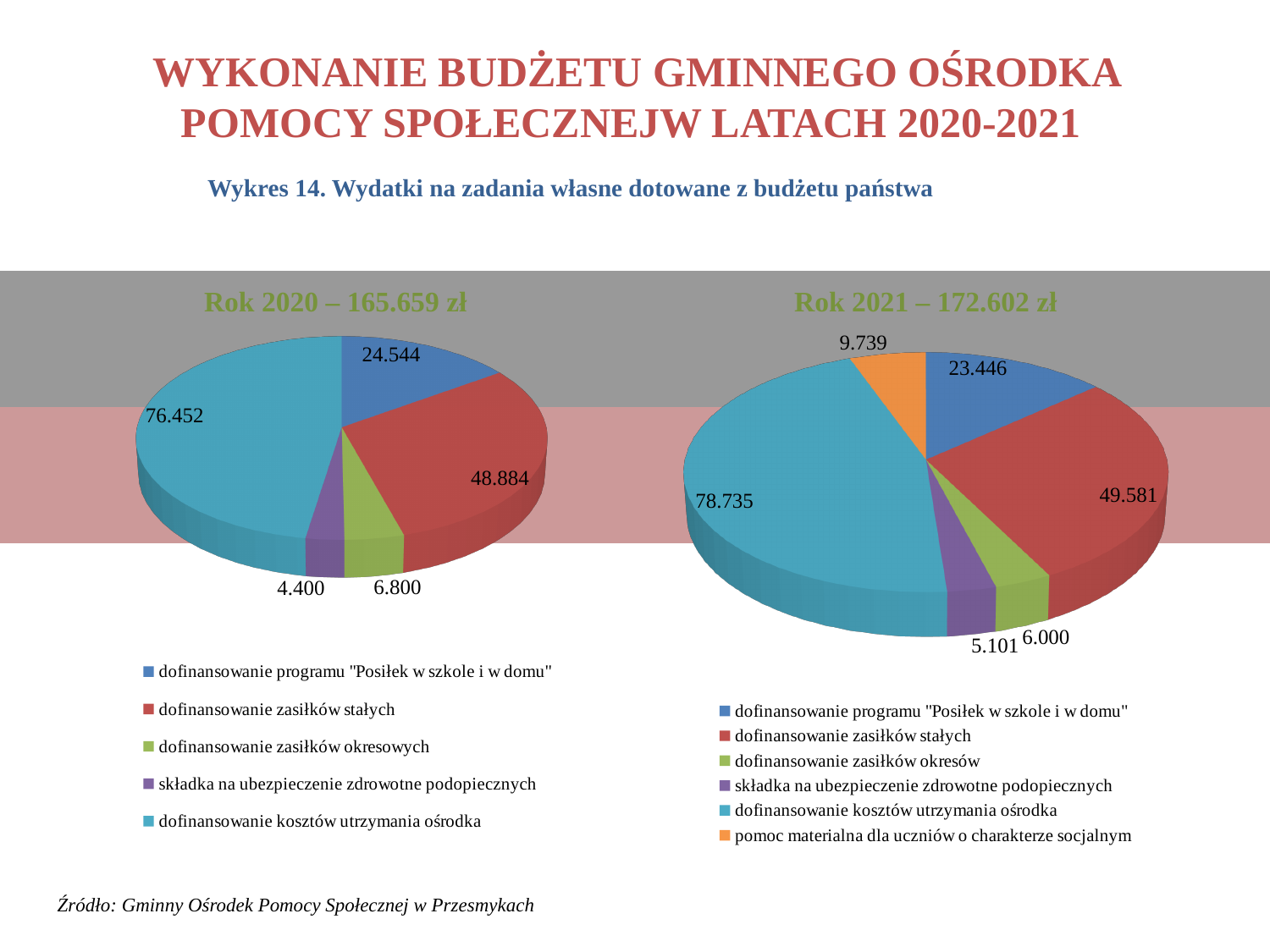
In the 'Rok 2020 – 165.659 zł' pie chart, which category has the largest slice? dofinansowanie kosztów utrzymania ośrodka How many slices does the 'Rok 2021 – 172.602 zł' pie chart have? 6 In the 'Rok 2020 – 165.659 zł' pie chart, what is the value for składka na ubezpieczenie zdrowotne podopiecznych? 4.400 How many slices does the 'Rok 2020 – 165.659 zł' pie chart have? 5 In the 'Rok 2020 – 165.659 zł' pie chart, what is the value for dofinansowanie kosztów utrzymania ośrodka? 76.452 What type of chart is used for 'Rok 2020 – 165.659 zł'? pie chart In the 'Rok 2021 – 172.602 zł' pie chart, what is the value for pomoc materialna dla uczniów o charakterze socjalnym? 9.739 In the 'Rok 2021 – 172.602 zł' pie chart, which is larger: dofinansowanie zasiłków stałych or dofinansowanie programu "Posiłek w szkole i w domu"? dofinansowanie zasiłków stałych In the 'Rok 2021 – 172.602 zł' pie chart, which category has the smallest slice? składka na ubezpieczenie zdrowotne podopiecznych By how much is the value for dofinansowanie kosztów utrzymania ośrodka in the 'Rok 2021 – 172.602 zł' chart higher than in the 'Rok 2020 – 165.659 zł' chart? 2.283 What total amount is shown in the title of the right-hand pie chart for 2021? 172.602 zł In the 'Rok 2020 – 165.659 zł' pie chart, what is the difference between dofinansowanie zasiłków stałych and dofinansowanie programu "Posiłek w szkole i w domu"? 24.340